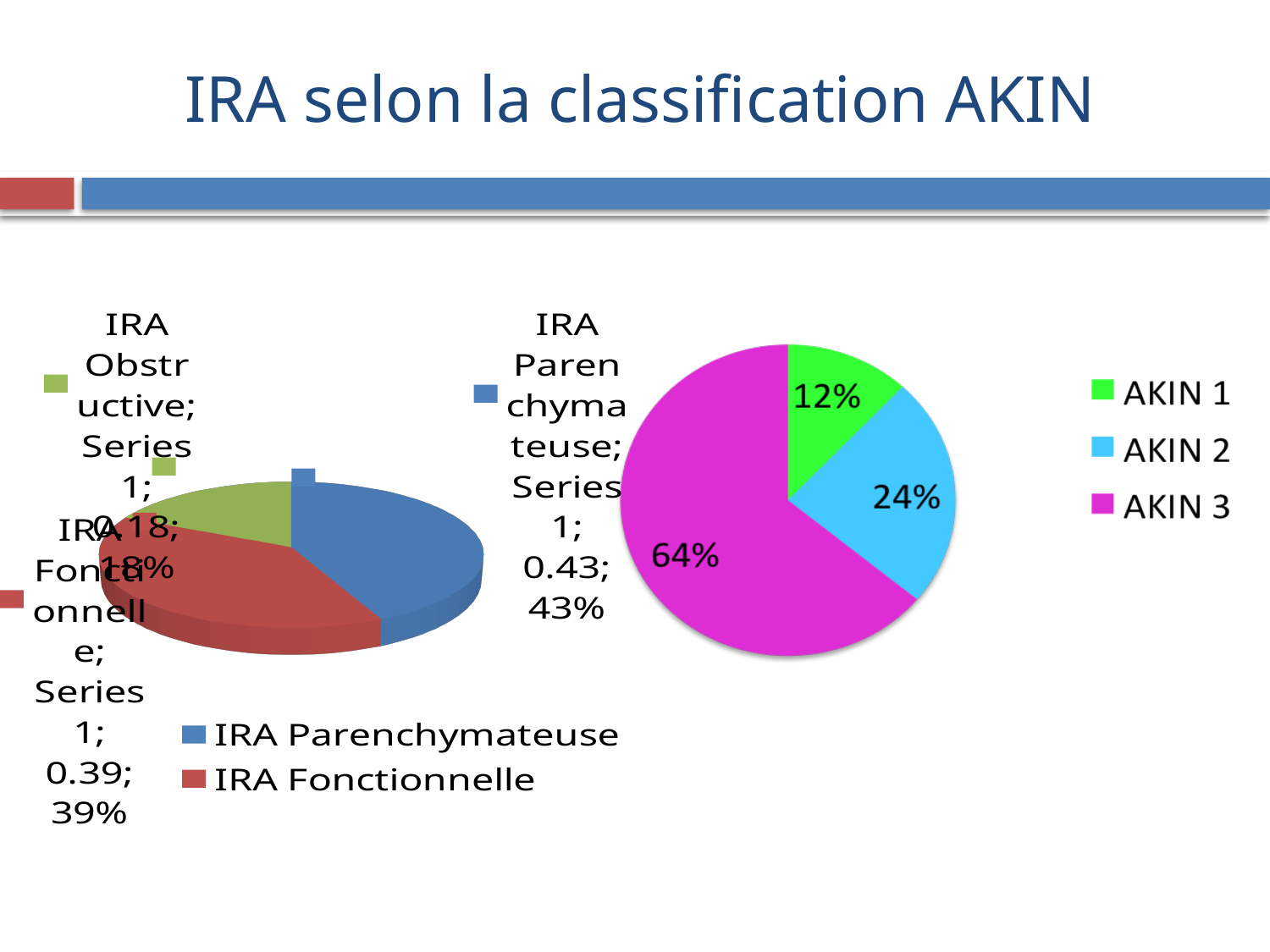
In the right pie chart (AKIN classification), what is the share for AKIN 3? 64% In the right pie chart (AKIN classification), which category has the smallest share? AKIN 1 In the right pie chart (AKIN classification), what is the share for AKIN 1? 12% In the left pie chart (IRA types), what is the share for IRA Parenchymateuse? 43% In the right pie chart (AKIN classification), how many categories does the legend list? 3 In the left pie chart (IRA types), what is the share for IRA Fonctionnelle? 39% In the right pie chart (AKIN classification), which category has the largest share? AKIN 3 In the left pie chart (IRA types), which category has the smallest share? IRA Obstructive In the right pie chart (AKIN classification), what is the share for AKIN 2? 24% In the left pie chart (IRA types), what is the share for IRA Obstructive? 18% What kind of chart is the chart on the right of the slide? Pie chart In the right pie chart (AKIN classification), what is the difference in percentage points between AKIN 3 and AKIN 2? 40